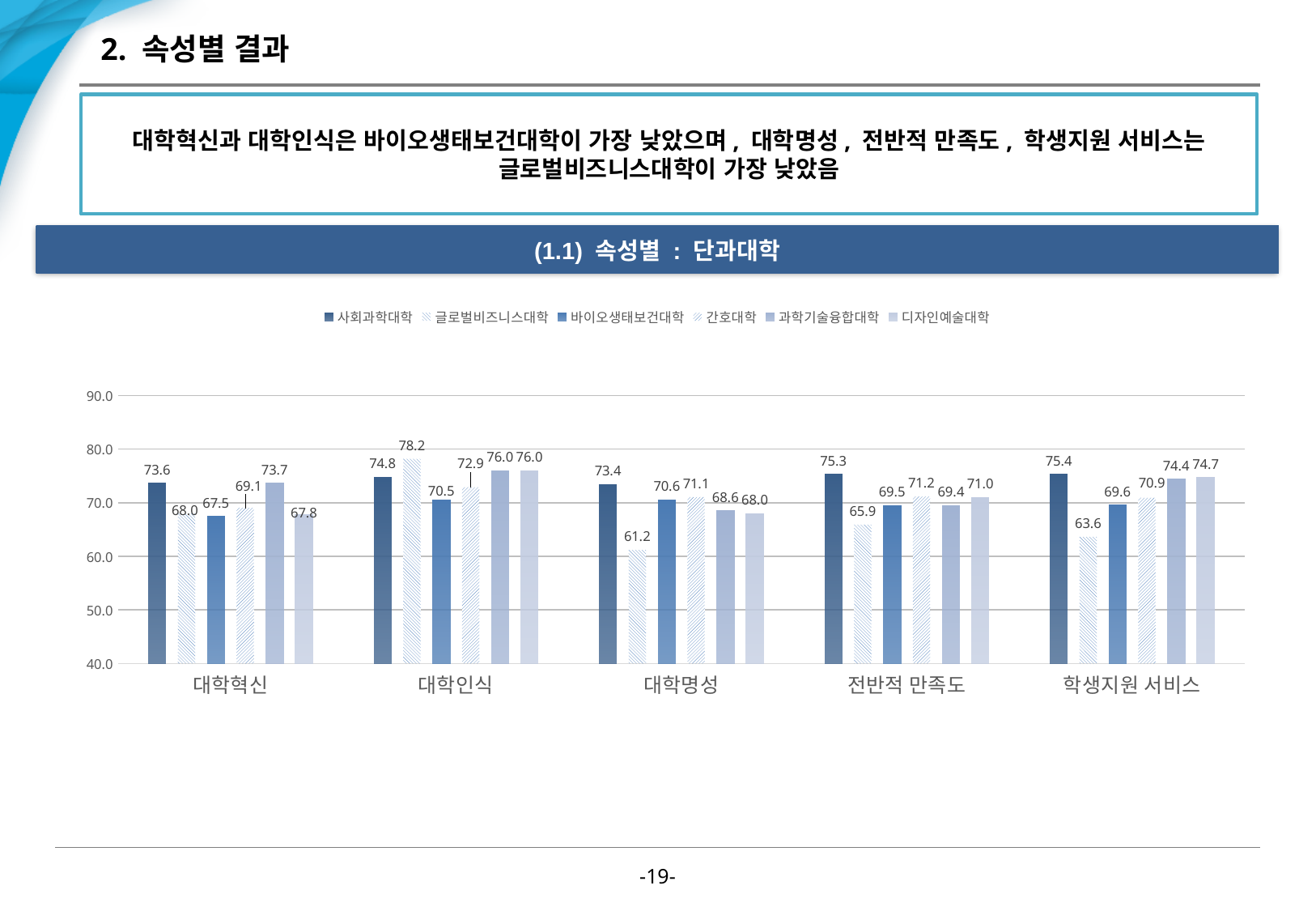
What type of chart is shown on the slide? bar chart What is the difference between 사회과학대학 and 글로벌비즈니스대학 in the 학생지원 서비스 category? 11.8 How many categories are shown on the x axis? 5 What is the title shown in the banner above the chart? (1.1) 속성별 : 단과대학 What is the value for 바이오생태보건대학 in the 대학혁신 category? 67.5 What is the value for 글로벌비즈니스대학 in the 대학명성 category? 61.2 Which college has the lowest value in the 전반적 만족도 category? 글로벌비즈니스대학 How many series does the legend list? 6 Is the value for 글로벌비즈니스대학 in the 대학인식 category greater or less than 70.0? greater Which is larger in the 대학명성 category: 간호대학 or 과학기술융합대학? 간호대학 Which college has the highest value in the 대학인식 category? 글로벌비즈니스대학 What is the value for 사회과학대학 in the 학생지원 서비스 category? 75.4